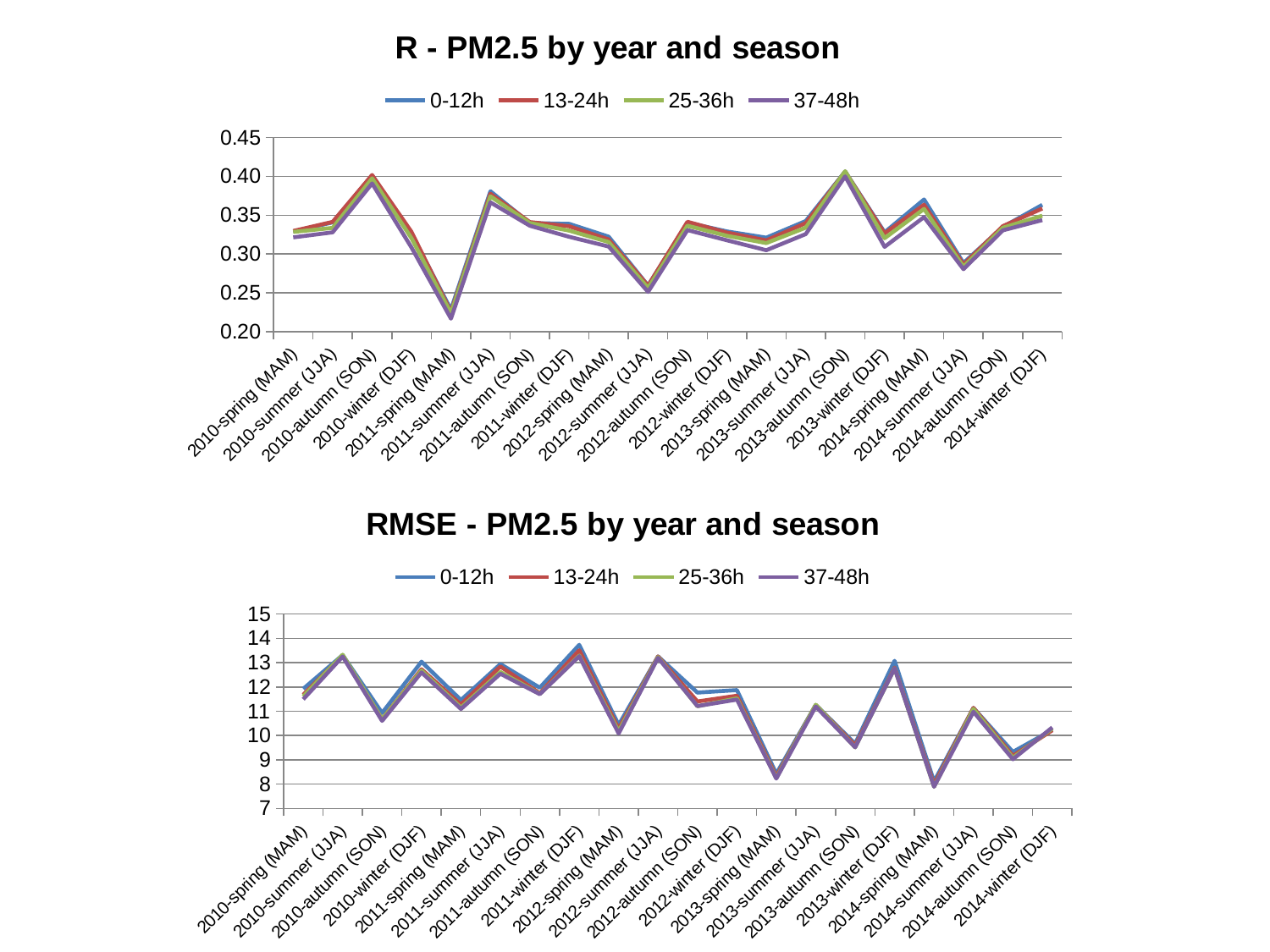
In the 'RMSE - PM2.5 by year and season' chart, do the values rise or fall from 2013-winter (DJF) to 2014-spring (MAM)? fall In the 'R - PM2.5 by year and season' chart, which category has the lowest R value? 2011-spring (MAM) In the 'R - PM2.5 by year and season' chart, is the value for 2012-summer (JJA) greater or less than 0.30? less What kind of chart is the 'R - PM2.5 by year and season' chart? line chart In the 'RMSE - PM2.5 by year and season' chart, is the value for 2011-winter (DJF) greater or less than 13? greater In the 'RMSE - PM2.5 by year and season' chart, which is larger, the value for 2010-summer (JJA) or the value for 2013-autumn (SON)? 2010-summer (JJA) In the 'R - PM2.5 by year and season' chart, is the value for 2013-autumn (SON) greater or less than 0.35? greater How many series does the legend of the 'RMSE - PM2.5 by year and season' chart list? 4 How many year-season categories are shown on the x axis of the 'R - PM2.5 by year and season' chart? 20 Which series is drawn in purple in the 'R - PM2.5 by year and season' chart? 37-48h